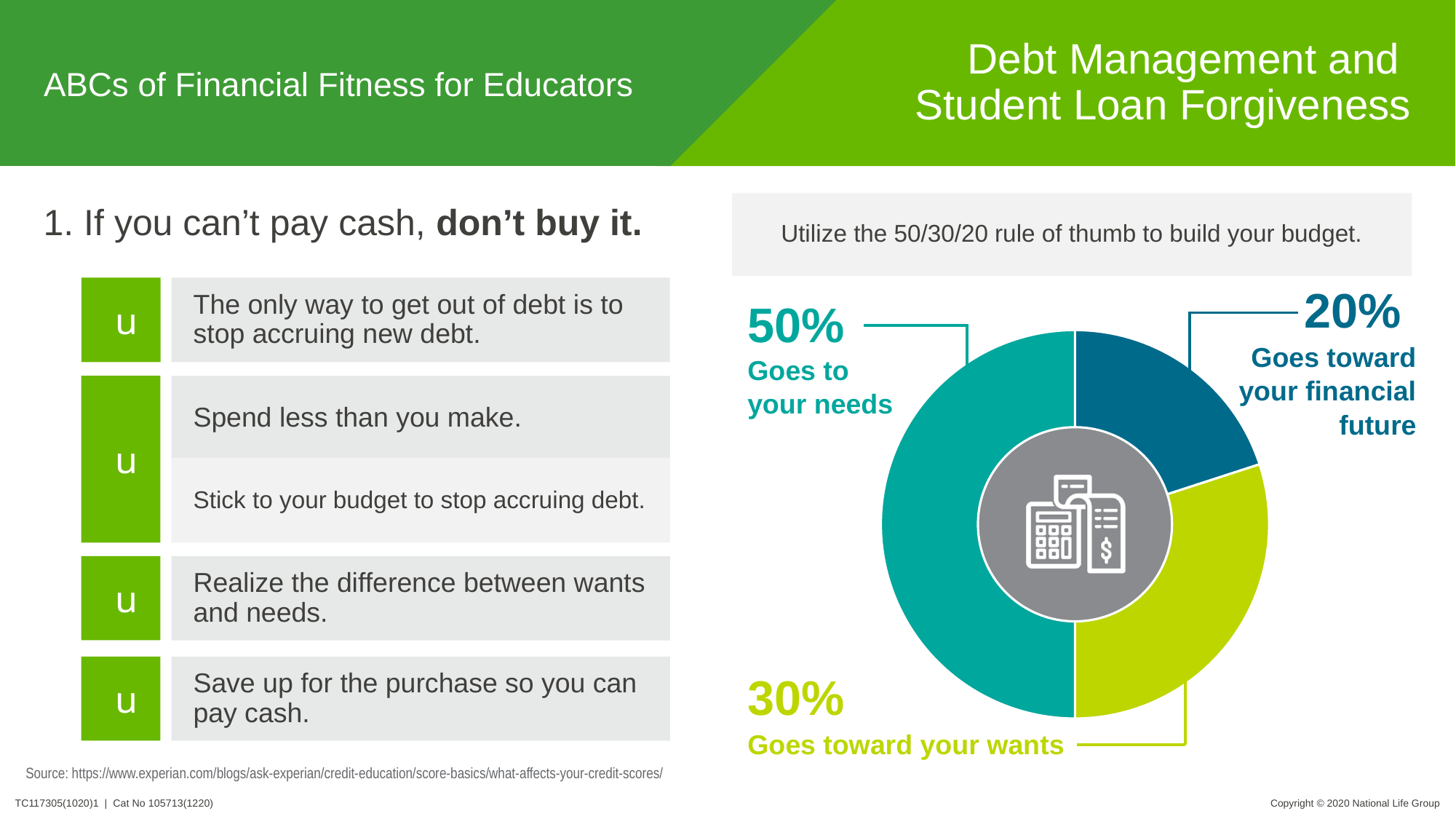
What kind of chart is used to show the 50/30/20 rule? Pie chart (donut) What is the difference between the share for needs and the share for wants? 20% What percentage of the budget goes toward your financial future? 20% Which category receives the smallest share of the budget in the chart? Goes toward your financial future How many categories are shown in the budget chart? 3 What percentage of the budget goes toward your wants? 30% Which is larger: the share for wants or the share for your financial future? Wants What do the three shares in the chart add up to? 100% What colour is the slice for the 20% that goes toward your financial future? Dark blue What percentage of the budget goes to your needs in the 50/30/20 chart? 50% What is the difference between the share for wants and the share for your financial future? 10% Which category receives the largest share of the budget in the chart? Goes to your needs